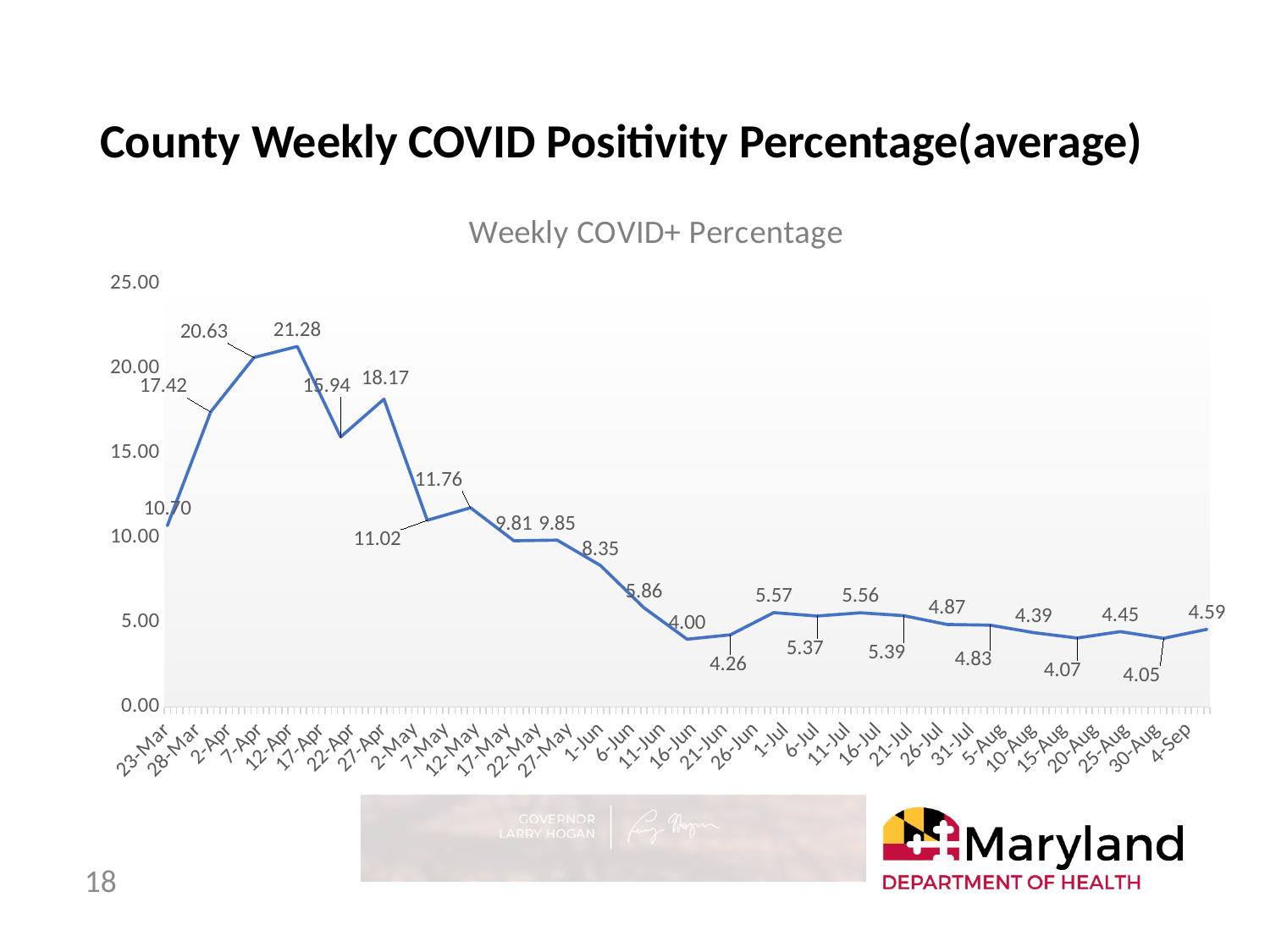
What is the difference between the highest value (21.28) and the lowest value (4.00)? 17.28 What is the value of the first data point, at 23-Mar? 10.70 Overall, do the values rise or fall from left to right across the chart? fall How many data points are plotted on the line? 25 What is the value of the last data point on the chart? 4.59 What is the difference between the two peak values 21.28 and 20.63? 0.65 What is the title of the chart? Weekly COVID+ Percentage What is the lowest value plotted on the chart? 4.00 What is the maximum value shown on the vertical axis? 25.00 What kind of chart is shown on the slide? line chart Which is larger, the value 18.17 or the value 15.94 that precedes it? 18.17 What is the highest value plotted on the chart? 21.28